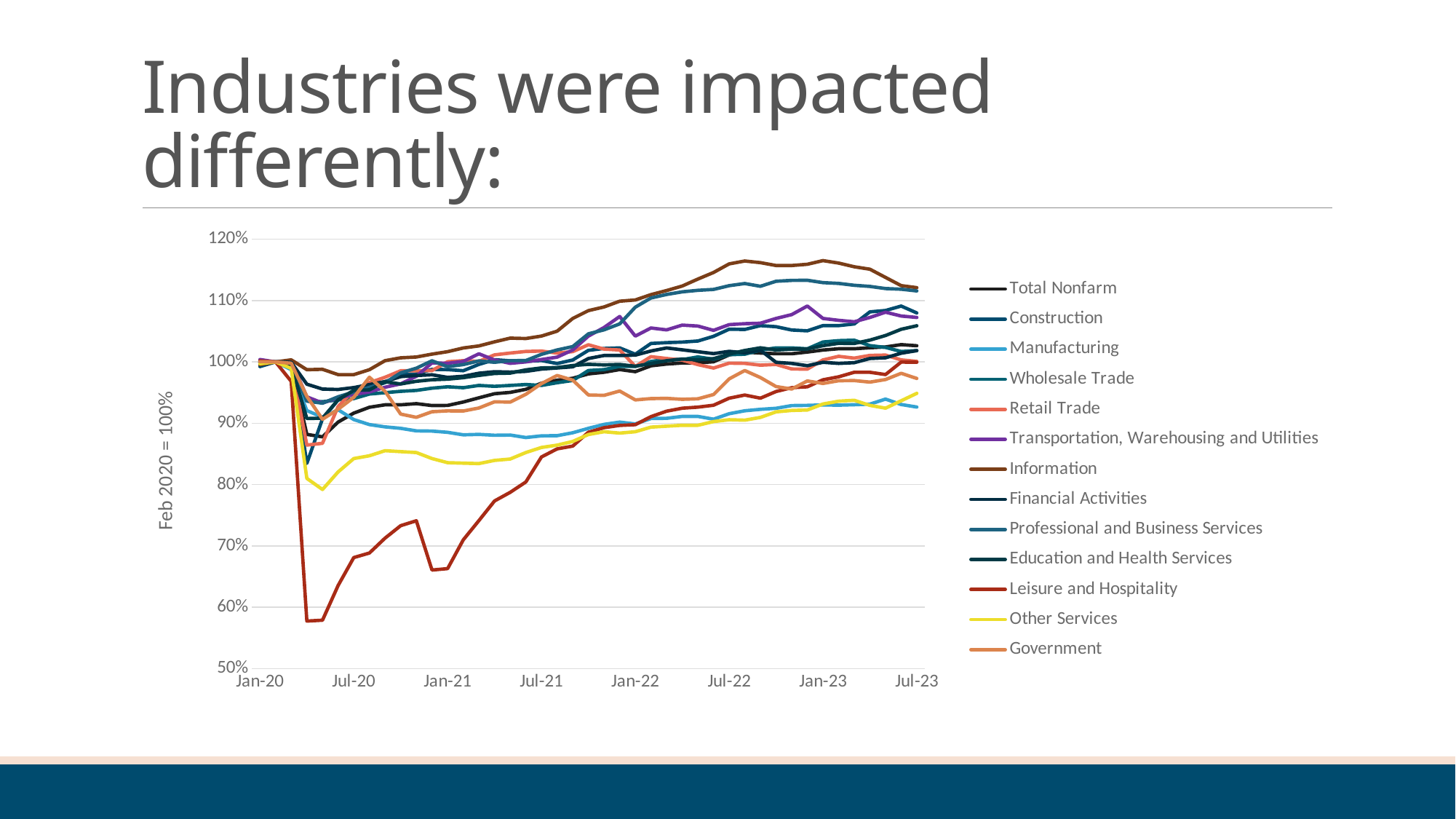
Is the peak value for Information greater or less than 110%? greater What kind of chart is shown on the slide? line chart Is the value for Other Services at Jan-21 greater or less than 90%? less Does the Leisure and Hospitality line generally rise or fall from Jul-20 to Jul-23? rise Is the lowest value for Leisure and Hospitality greater or less than 60%? less At Jul-23, which is higher: Information or Manufacturing? Information Which industry reached the highest value on the chart? Information Which industry fell to the lowest value on the chart during 2020? Leisure and Hospitality What is the label on the vertical axis of the chart? Feb 2020 = 100% How many series does the legend list? 13